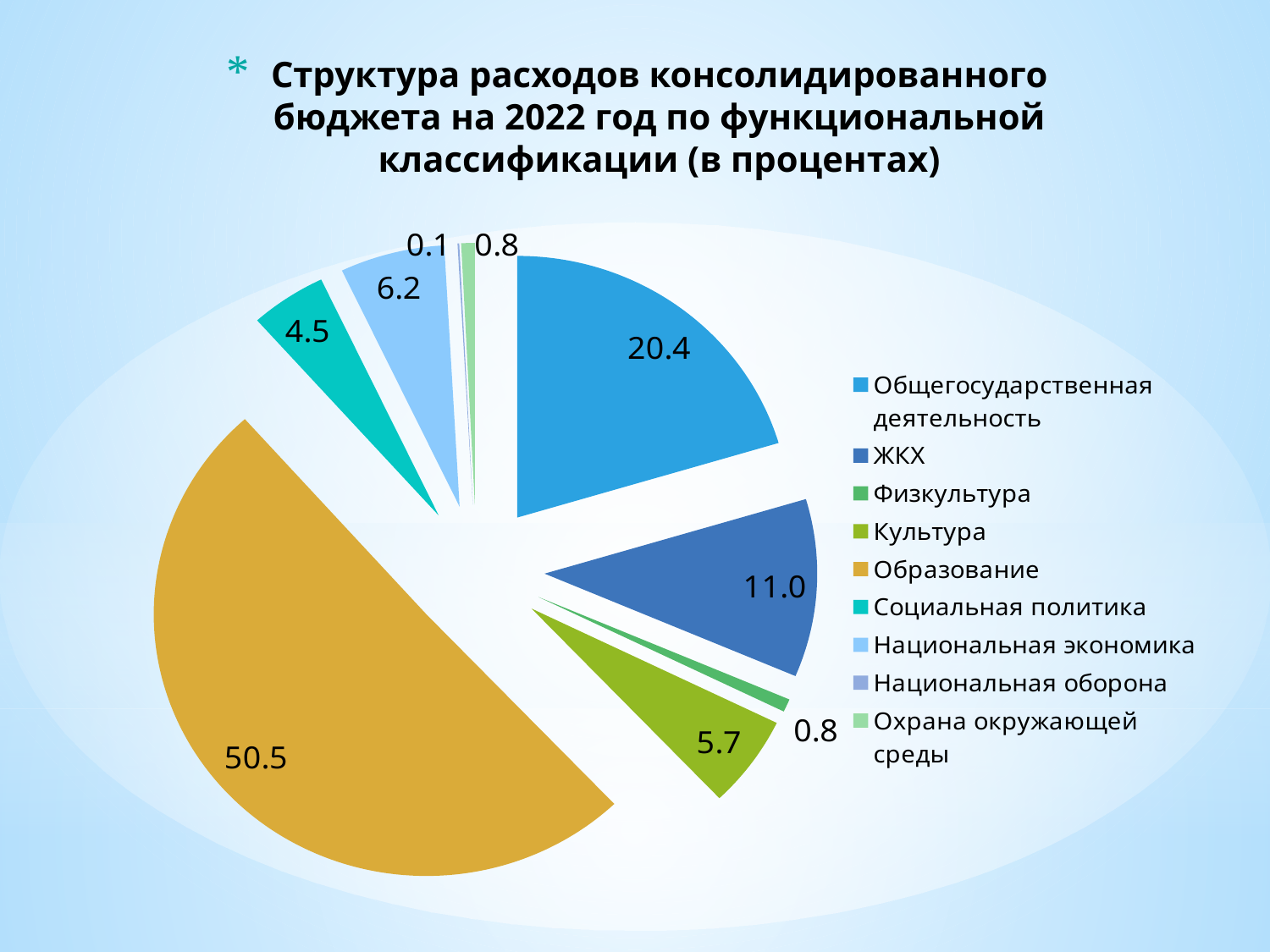
What is the value for ЖКХ? 11.0 What kind of chart is shown on the slide? pie chart Which category has the largest share of the pie? Образование What is the difference between the values for Образование and Общегосударственная деятельность? 30.1 How many categories does the legend list? 9 What is the value for Общегосударственная деятельность? 20.4 What is the title of the chart? Структура расходов консолидированного бюджета на 2022 год по функциональной классификации (в процентах) What is the value for Национальная экономика? 6.2 Which is larger, the value for Культура or the value for Национальная экономика? Национальная экономика What is the value for Социальная политика? 4.5 What is the value for Образование? 50.5 Which category has the smallest share of the pie? Национальная оборона